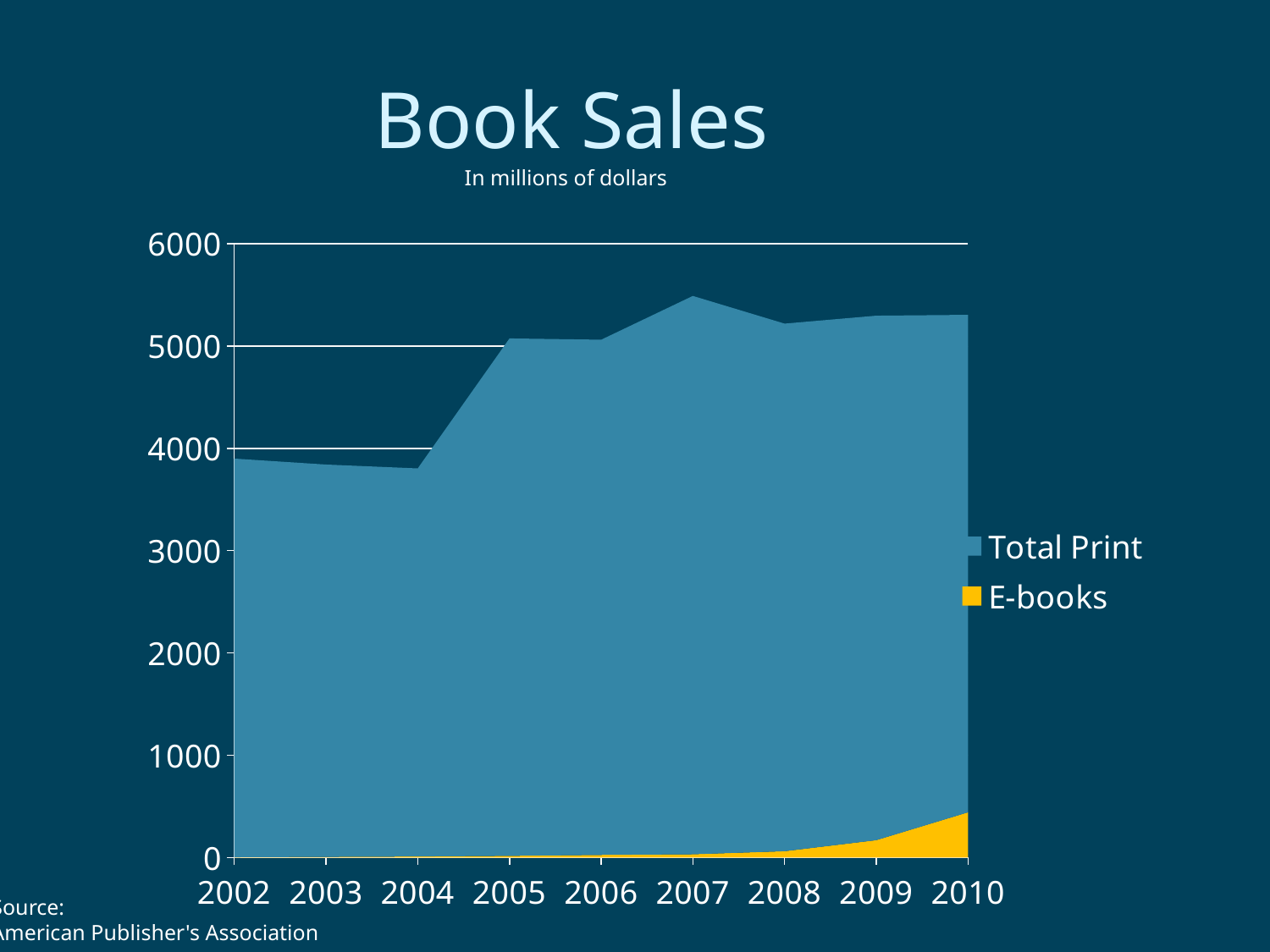
In which year does Total Print reach its highest value? 2007 What is the title of the chart? Book Sales Is the Total Print value for 2007 greater or less than 5000? greater Which year has the larger Total Print value, 2004 or 2005? 2005 How many years are plotted along the x axis? 9 In which year is the E-books value highest? 2010 How many series does the legend list? 2 Do E-books sales rise or fall from 2002 to 2010? Rise What kind of chart is shown on the slide? Area chart Is the E-books value for 2010 greater or less than 1000? less In what units are the values shown, according to the subtitle? In millions of dollars Is the Total Print value for 2002 greater or less than 4000? less